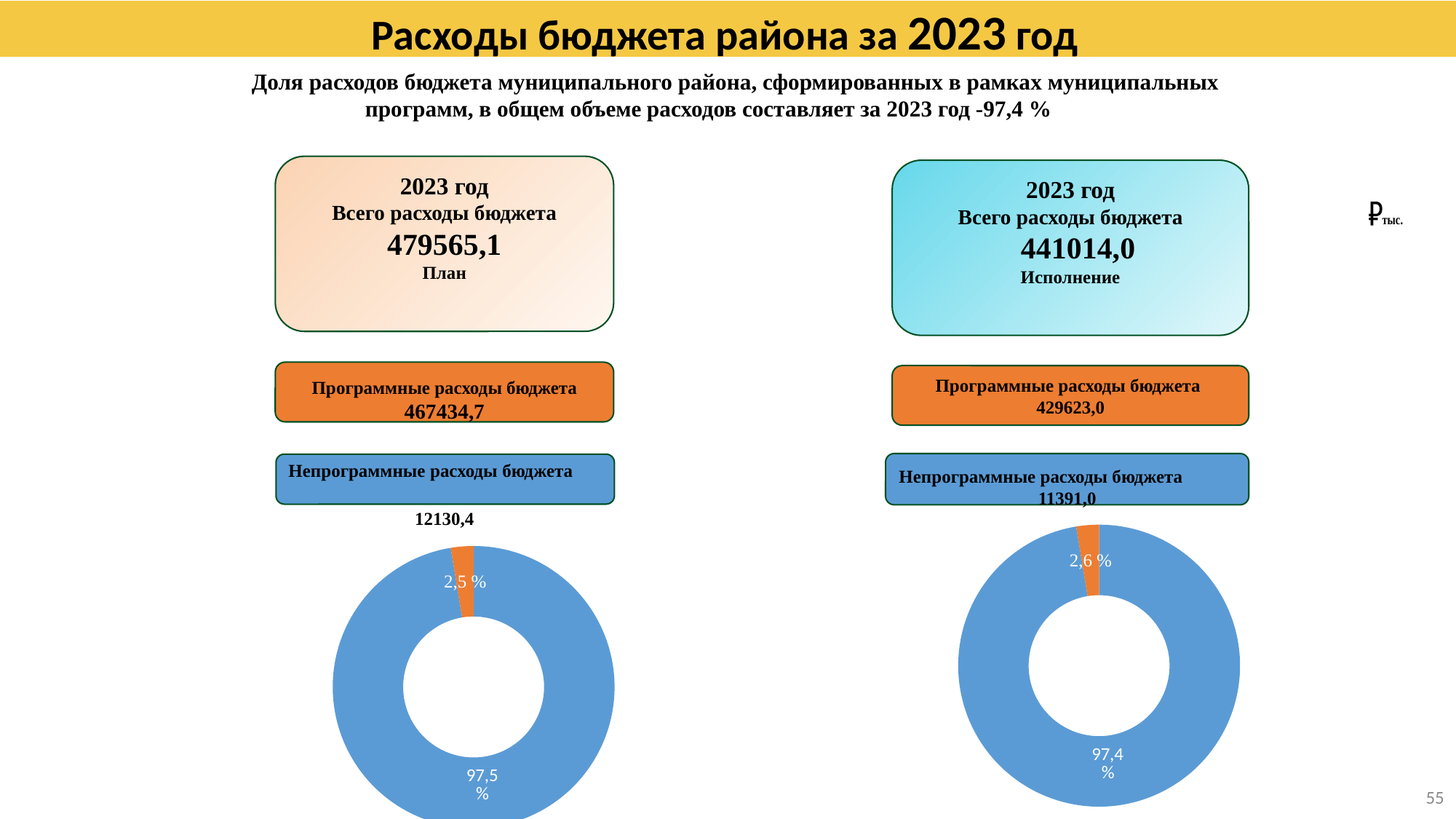
In the right doughnut chart (Исполнение), what percentage is shown for the small orange slice? 2,6 % In the right doughnut chart (Исполнение), what percentage is shown for the large blue slice? 97,4 % In the left doughnut chart (План), what percentage is shown for the large blue slice? 97,5 % In the right doughnut chart (Исполнение), what is the difference in percentage points between the blue slice and the orange slice? 94,8 percentage points What kind of chart is shown on the left side of the slide under the 'План' boxes? Doughnut (pie) chart In the right doughnut chart (Исполнение), which slice is larger, the blue one or the orange one? The blue one How many slices does the left doughnut chart (План) have? 2 In the left doughnut chart (План), which slice has the smallest share? The orange slice (2,5 %) How many doughnut charts are shown on the slide? 2 What colour is the largest slice in the right doughnut chart (Исполнение)? Blue In the left doughnut chart (План), what percentage is shown for the small orange slice? 2,5 % In the left doughnut chart (План), what is the difference in percentage points between the blue slice and the orange slice? 95 percentage points